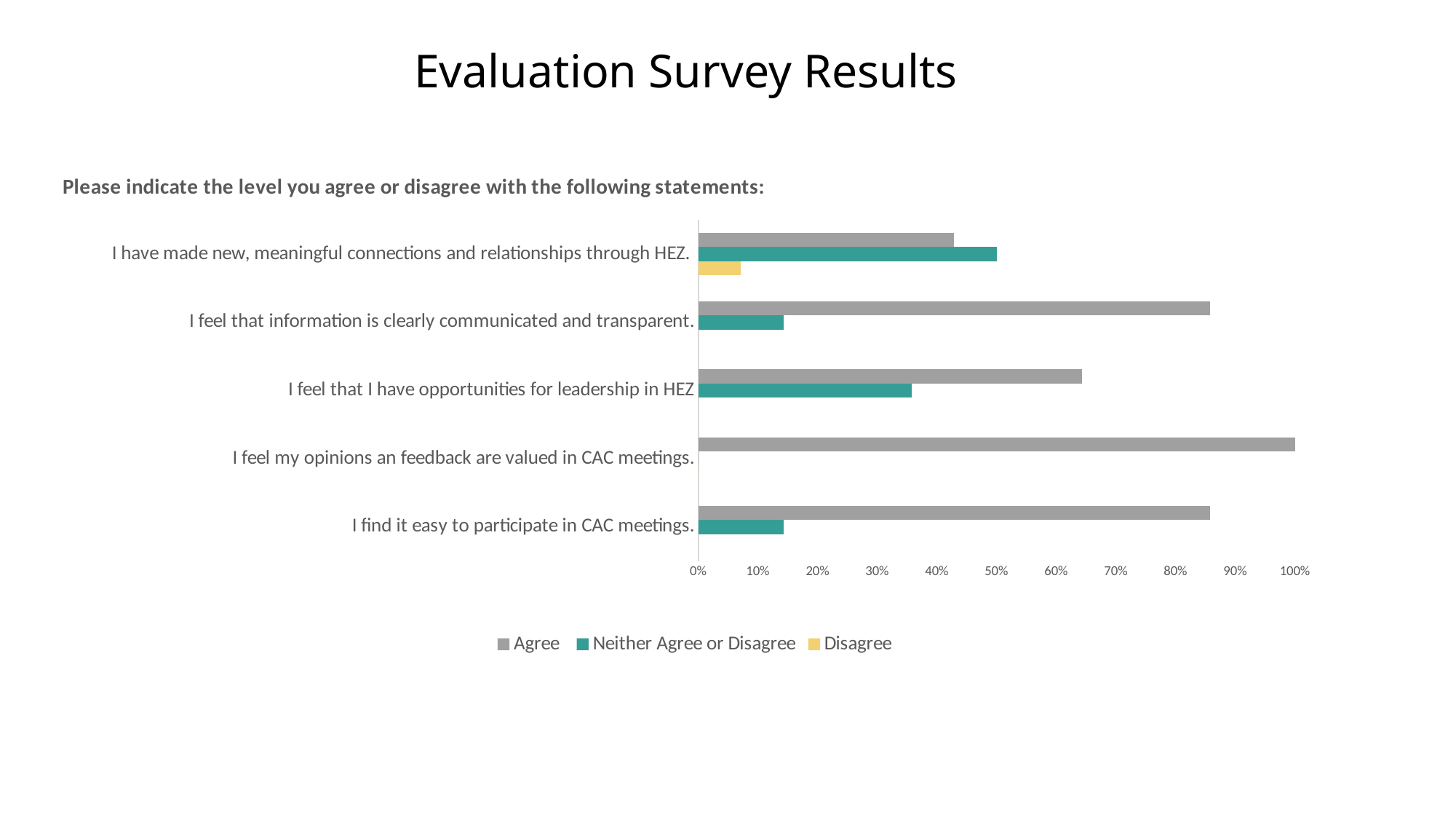
For "I have made new, meaningful connections and relationships through HEZ.", which is larger: the Agree value or the Neither Agree or Disagree value? Neither Agree or Disagree Which statement has the lowest Agree value? I have made new, meaningful connections and relationships through HEZ. Which has the larger Agree value: "I feel that I have opportunities for leadership in HEZ" or "I find it easy to participate in CAC meetings."? I find it easy to participate in CAC meetings. What is the Agree value for "I feel my opinions an feedback are valued in CAC meetings."? 100% What kind of chart is shown on the slide? bar chart How many statements (categories) are plotted on the chart? 5 Which statement has the highest Agree value? I feel my opinions an feedback are valued in CAC meetings. Is the Disagree value for "I have made new, meaningful connections and relationships through HEZ." greater or less than 10%? less How many series does the legend list? 3 Which statement is the only one with a Disagree bar? I have made new, meaningful connections and relationships through HEZ. Is the Agree value for "I feel that information is clearly communicated and transparent." greater or less than 80%? greater Is the Neither Agree or Disagree value for "I feel that I have opportunities for leadership in HEZ" greater or less than 30%? greater